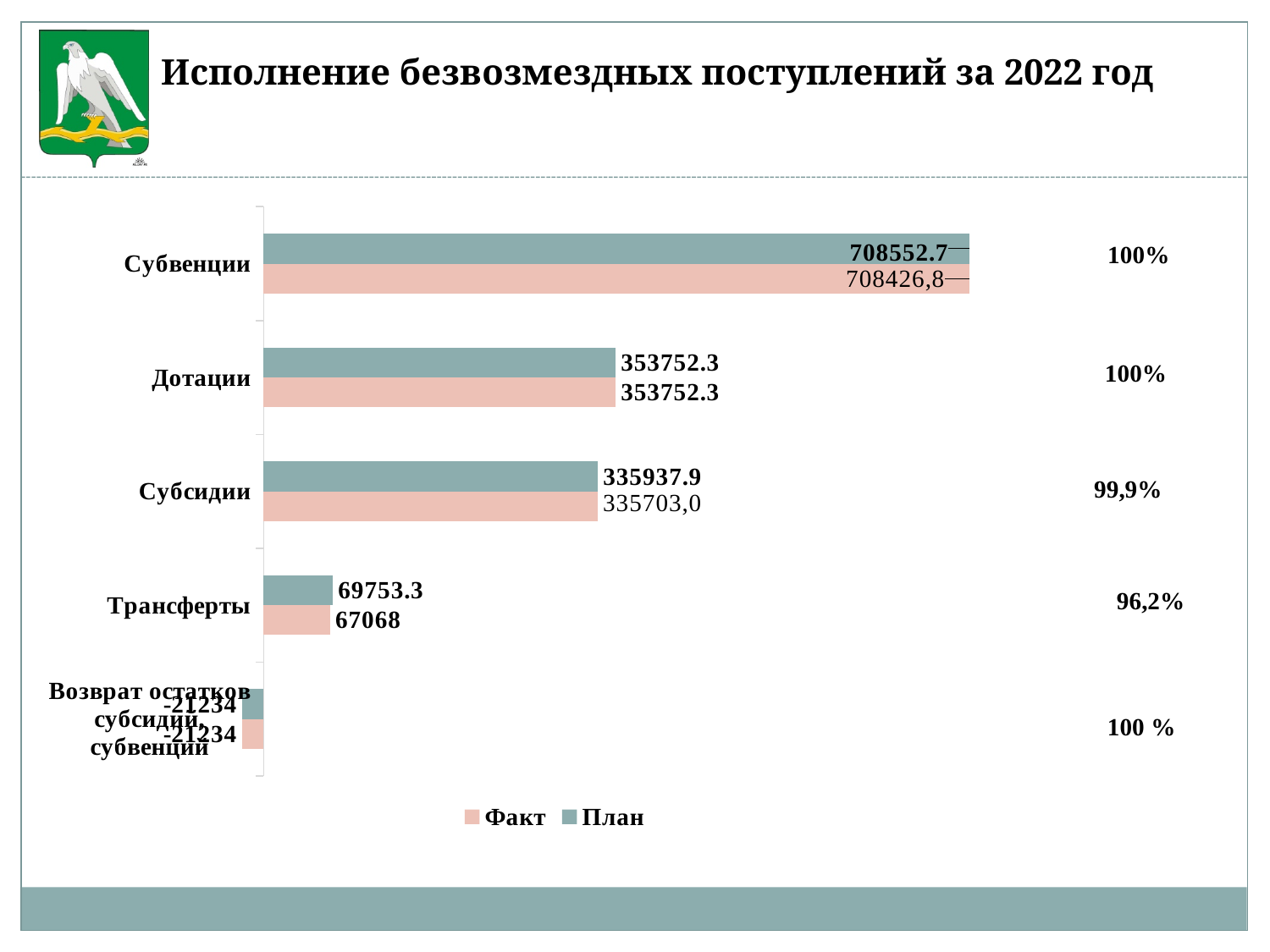
What is the План value for Субвенции? 708552.7 What kind of chart is shown on the slide? Bar chart How many categories are shown in the chart? 5 Which category has the lowest Факт value? Возврат остатков субсидий, субвенций How many series does the legend list? 2 Which category has the highest План value? Субвенции Which is larger, the План value for Дотации or the План value for Субсидии? Дотации What is the План value for Возврат остатков субсидий, субвенций? -21234 What is the Факт value for Трансферты? 67068 What is the Факт value for Субсидии? 335703,0 What is the Факт value for Субвенции? 708426,8 What is the difference between the План and Факт values for Трансферты? 2685.3